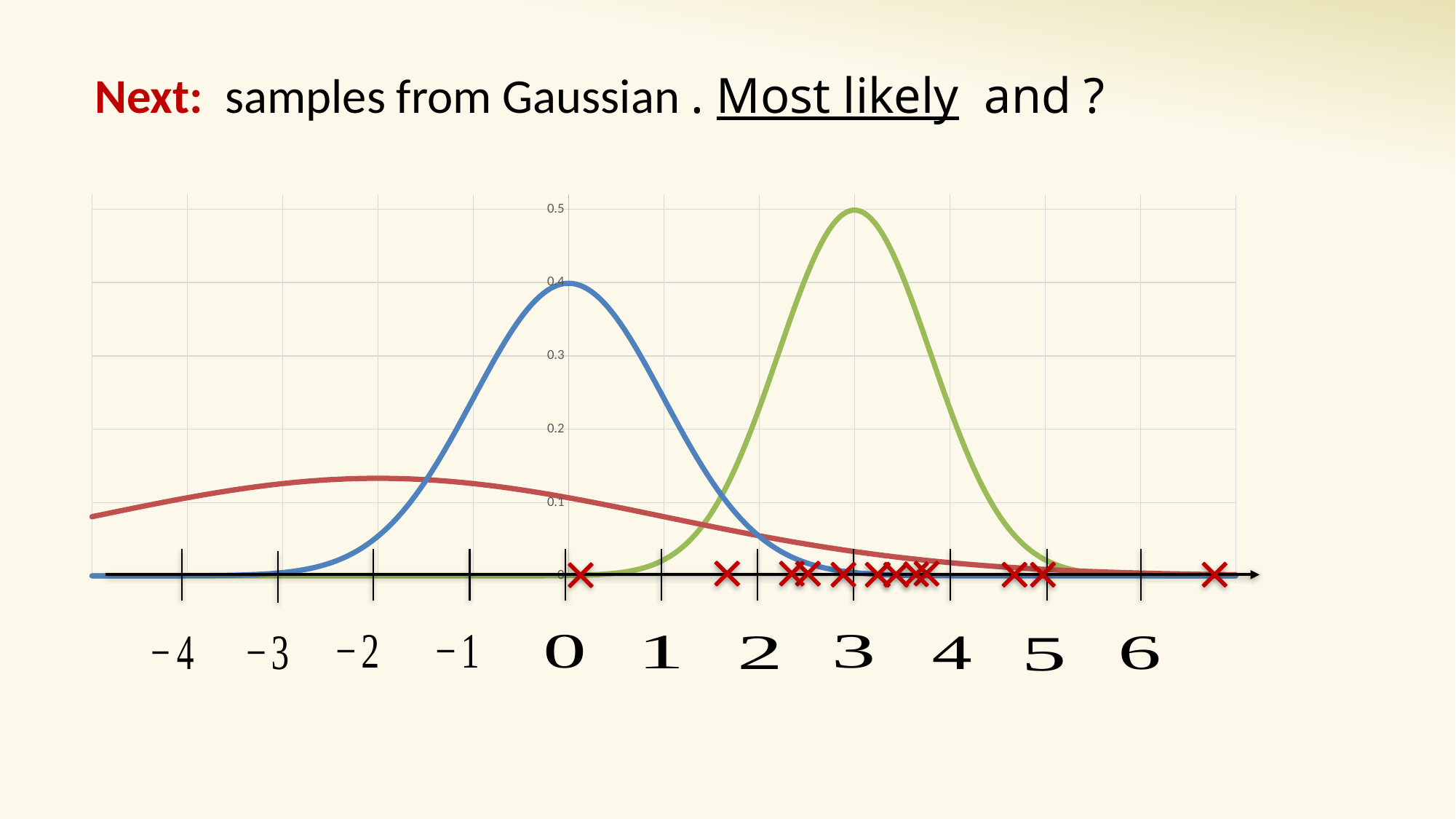
What kind of chart is shown on the slide? line chart At which x value does the green curve reach its peak? 3 At which x value does the blue curve reach its peak? 0 What is the peak value of the green curve? 0.5 Which curve has the lowest peak value? the red curve Which curve reaches the highest peak value? the green curve What colour are the sample marks (X) drawn along the x axis? red Which has a higher peak, the blue curve or the green curve? the green curve Is the peak value of the red curve greater or less than 0.2? less What is the highest tick label shown on the y axis? 0.5 How many curves are plotted on the chart? 3 What is the peak value of the blue curve? 0.4